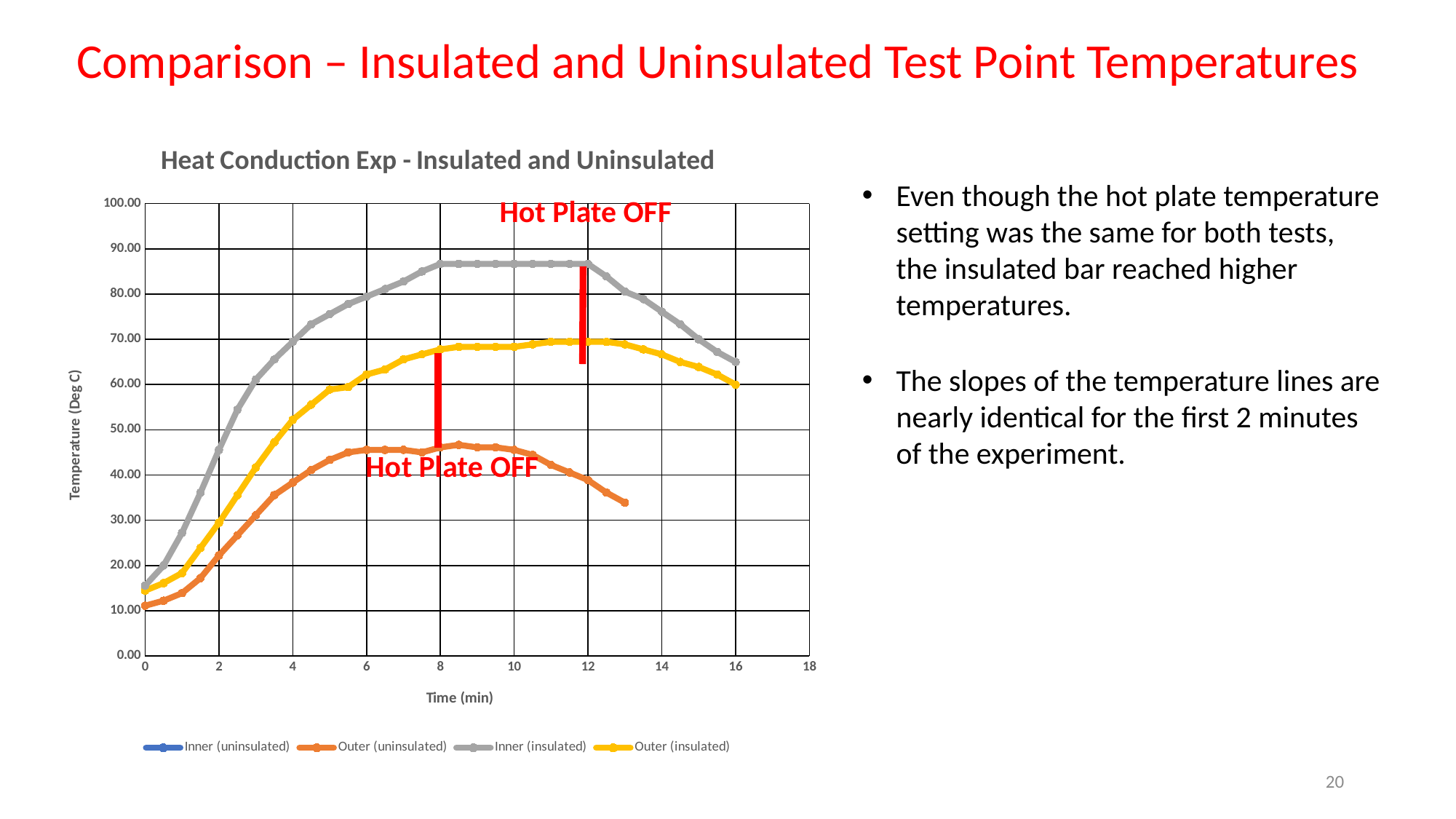
Does the Outer (uninsulated) line rise or fall between 10 and 13 min? fall What kind of chart is shown on the slide? line chart Is the value for Outer (insulated) at 8 min greater or less than 60.00? greater Is the value for Inner (insulated) at 12 min greater or less than 80.00? greater What is the label of the y axis of the chart? Temperature (Deg C) Is the value for Outer (uninsulated) at 13 min greater or less than 40.00? less What is the title of the chart? Heat Conduction Exp - Insulated and Uninsulated Does the Inner (insulated) line rise or fall between 0 and 8 min? rise At 10 min, which is larger: Inner (insulated) or Outer (insulated)? Inner (insulated) How many series does the chart legend list? 4 Which series reaches the highest temperature on the chart? Inner (insulated)